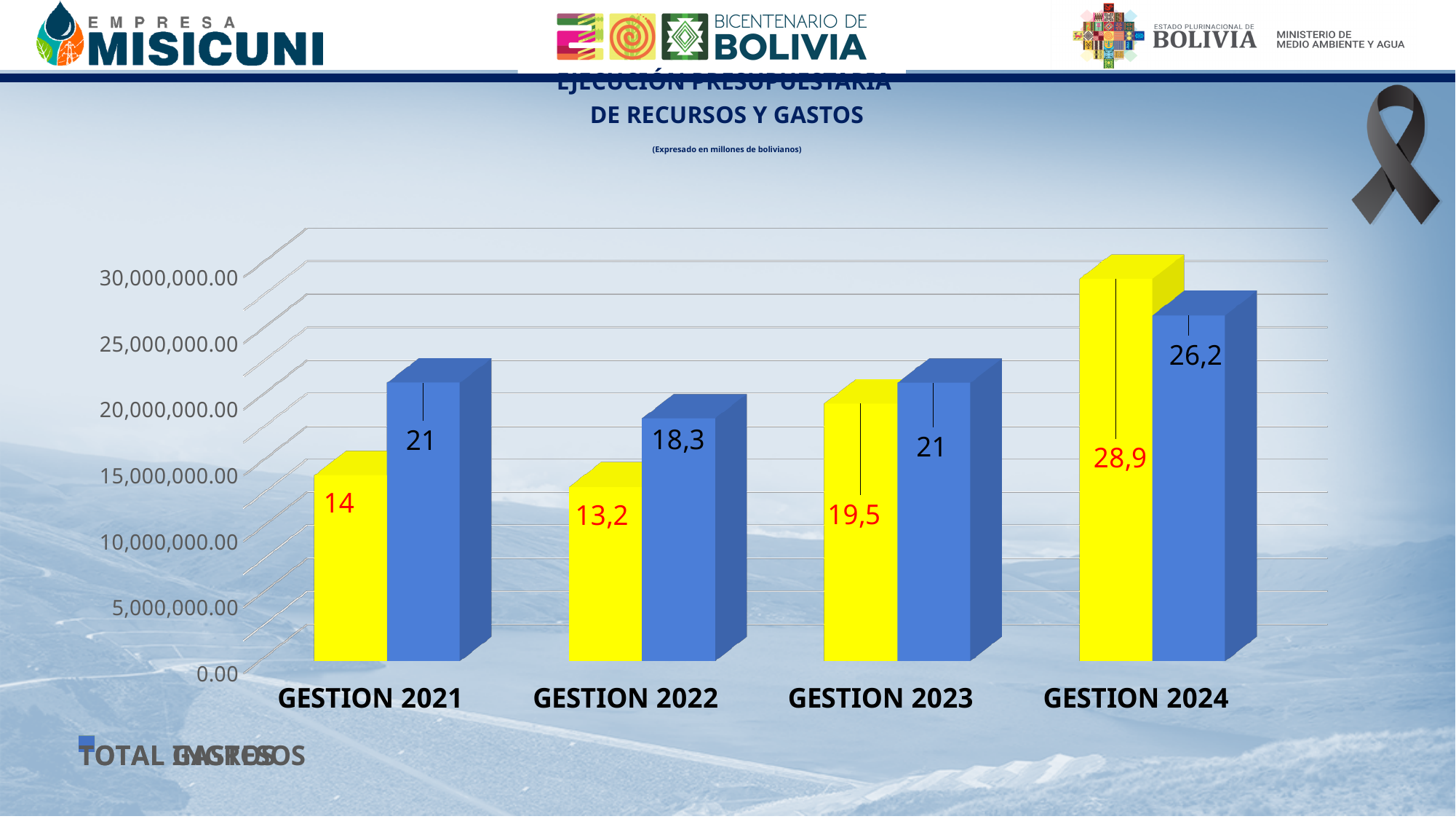
How many categories (gestiones) are shown on the x axis? 4 In what unit are the chart values expressed, according to the subtitle? millones de bolivianos What is the value of the yellow bar for GESTION 2021? 14 For GESTION 2023, which is larger, the yellow bar or the blue bar? the blue bar What kind of chart is shown on the slide? bar chart What is the value of the blue bar for GESTION 2024? 26,2 Do the yellow bars rise or fall from GESTION 2022 to GESTION 2024? rise What is the value of the blue bar for GESTION 2022? 18,3 For GESTION 2024, what is the difference between the yellow bar and the blue bar? 2,7 Which category has the lowest yellow bar? GESTION 2022 What is the value of the yellow bar for GESTION 2024? 28,9 Which category has the highest yellow bar? GESTION 2024